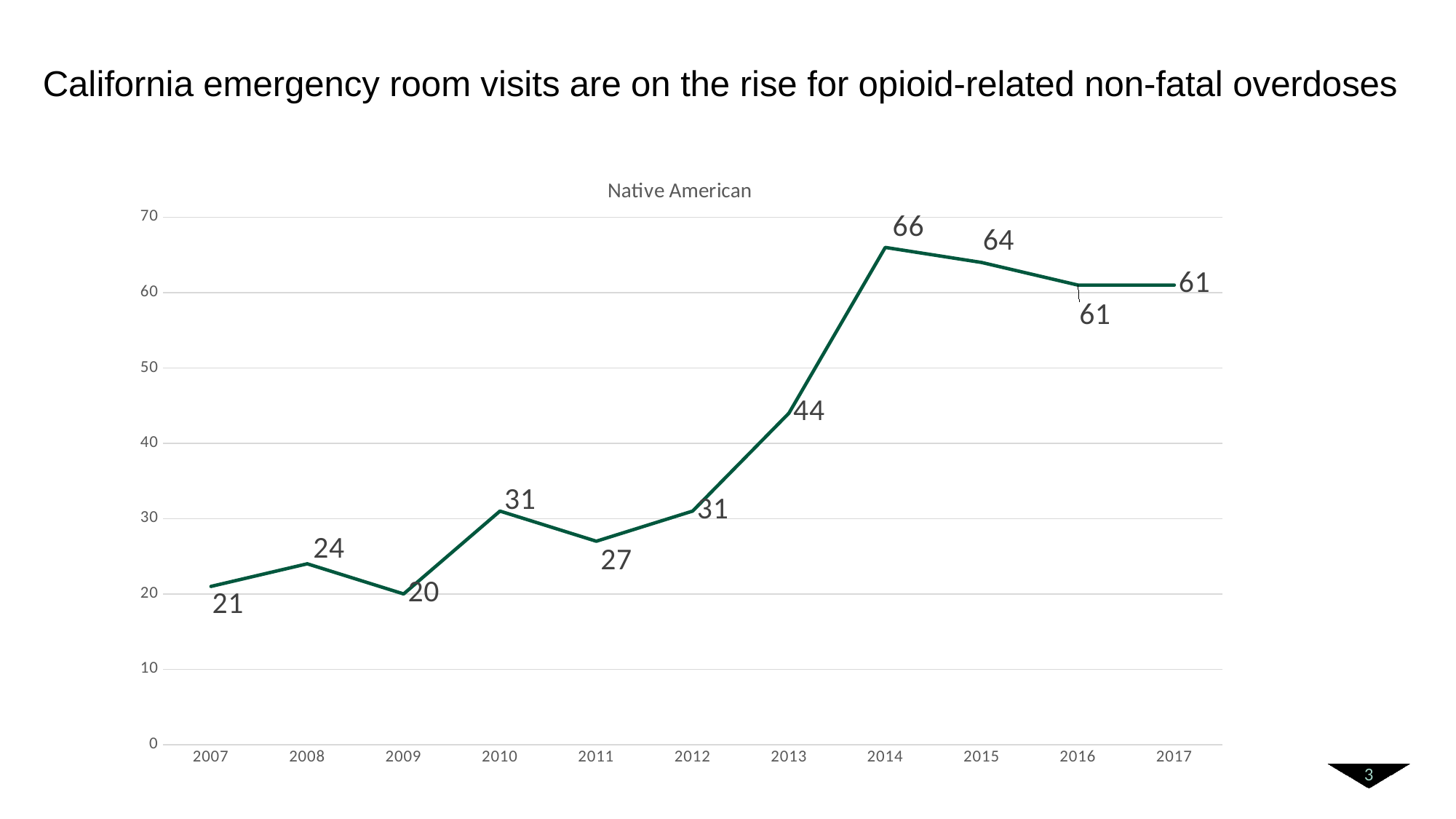
What kind of chart is shown? line chart How many years are plotted on the x axis? 11 What is the title of the chart? Native American What is the difference between the values for 2015 and 2016? 3 Which year has the lowest value? 2009 What is the value for 2009? 20 What is the value for 2014? 66 Which is larger, the value for 2011 or the value for 2013? 2013 Which year has the highest value? 2014 What is the value for 2013? 44 Do the values rise or fall from 2009 to 2014? rise What is the difference between the values for 2014 and 2007? 45